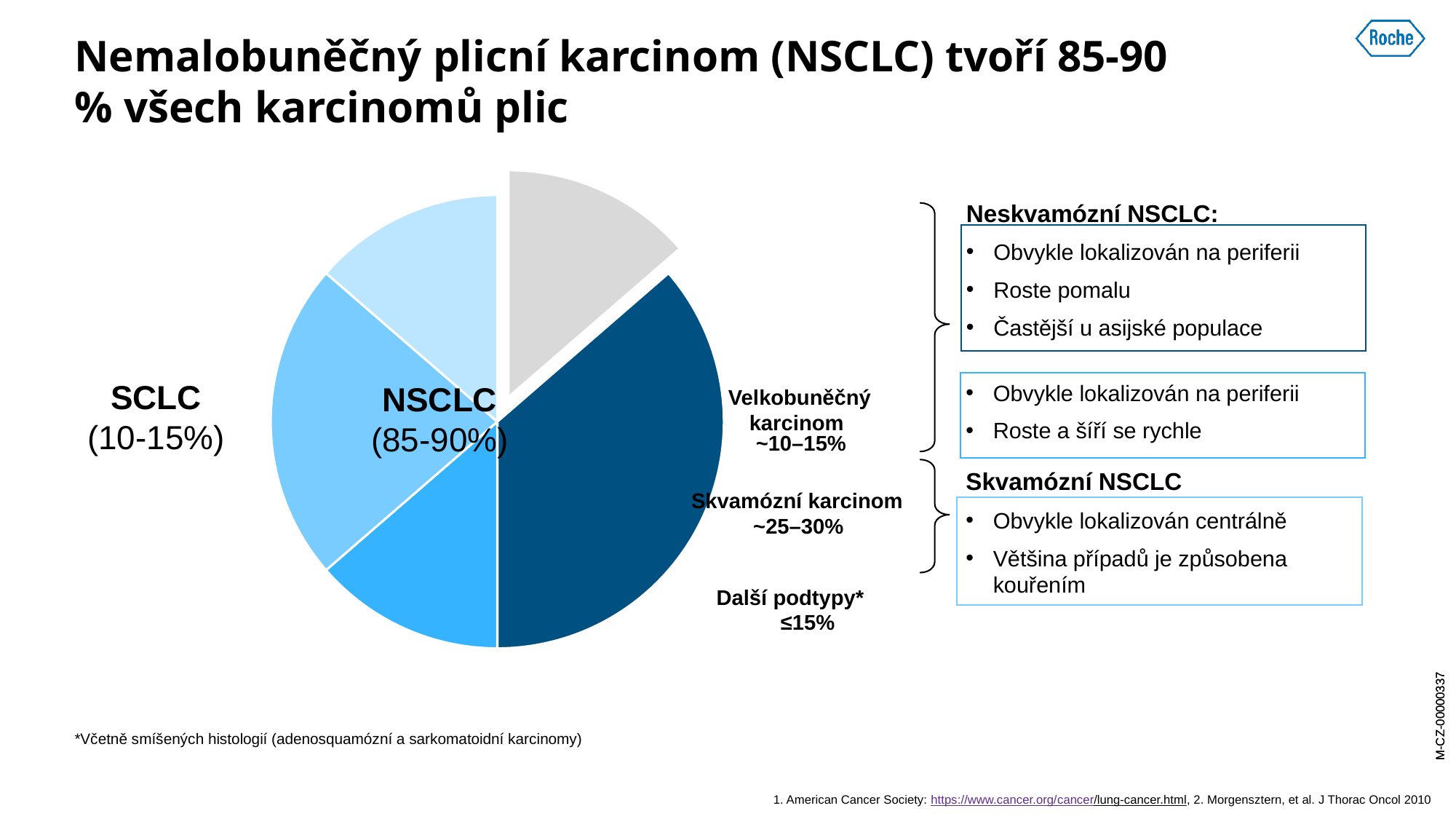
What is the title of the slide? Nemalobuněčný plicní karcinom (NSCLC) tvoří 85-90 % všech karcinomů plic What share of lung carcinomas does the chart give for SCLC? 10-15% What kind of chart is shown on the slide? pie chart Which is larger according to the chart, NSCLC or SCLC? NSCLC Which is larger according to the chart, Skvamózní karcinom or Velkobuněčný karcinom? Skvamózní karcinom What colour is the slice that is separated (exploded) from the top of the pie? grey How many slices does the pie chart have? 5 What share is printed for Skvamózní karcinom? ~25–30% What share of lung carcinomas does the chart give for NSCLC? 85-90% Which slice of the pie is the largest? the dark blue slice What share is printed for Další podtypy*? ≤15% What share is printed for Velkobuněčný karcinom? ~10–15%